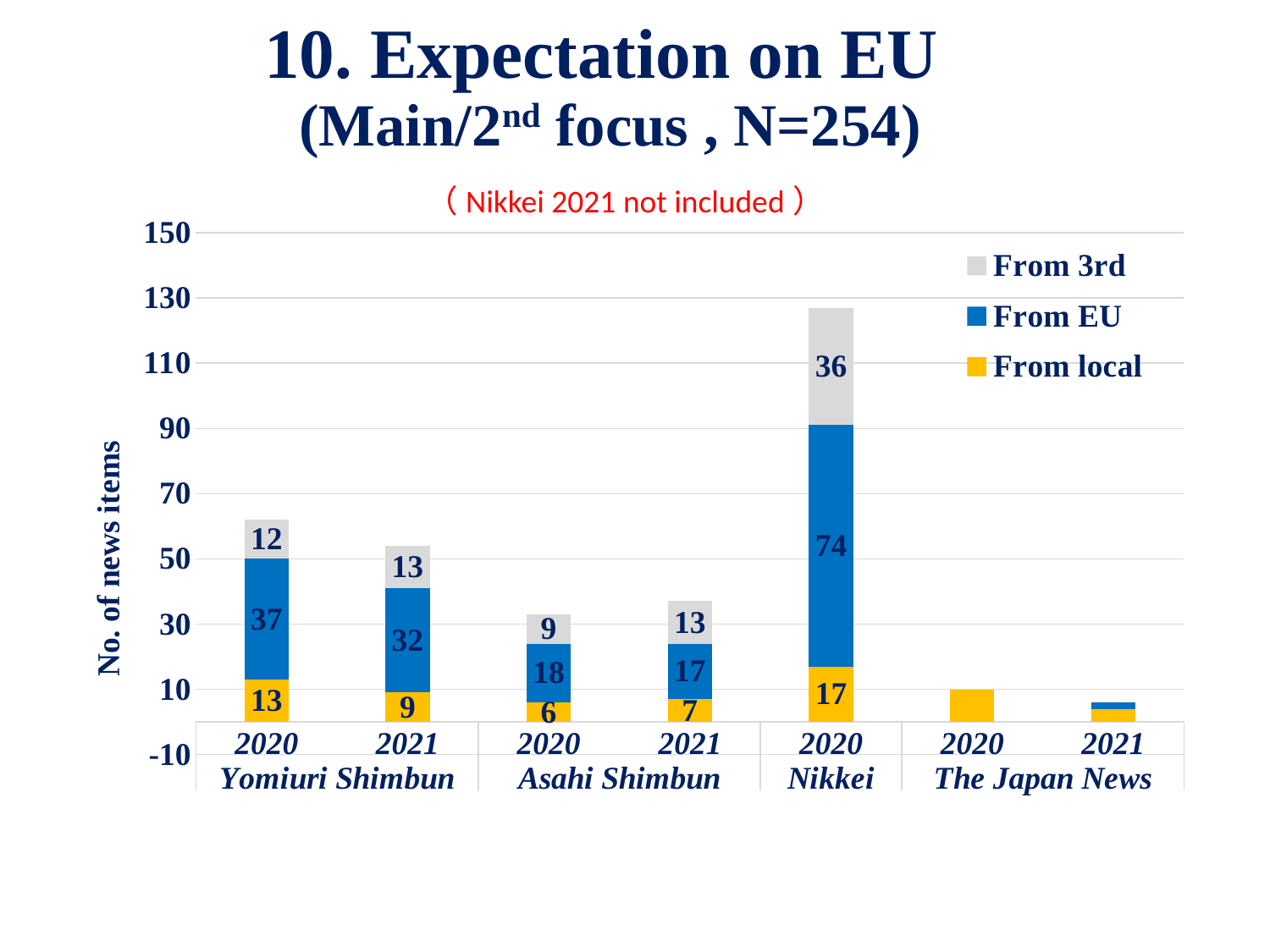
How many series does the legend list? 3 What kind of chart is shown on the slide? stacked bar chart What is the title of the vertical axis? No. of news items What is the 'From 3rd' value for Asahi Shimbun 2021? 13 Is the total for the Nikkei 2020 bar greater or less than 110? greater What is the 'From local' value for Yomiuri Shimbun 2020? 13 Which is larger, the 'From 3rd' value for Nikkei 2020 or for Yomiuri Shimbun 2020? Nikkei 2020 What is the difference between the 'From EU' values for Yomiuri Shimbun 2020 and 2021? 5 What is the 'From EU' value for Nikkei 2020? 74 Which bar has the highest 'From EU' value? Nikkei 2020 What is the total of the stacked bar for Yomiuri Shimbun 2020? 62 What is the total of the stacked bar for Nikkei 2020? 127